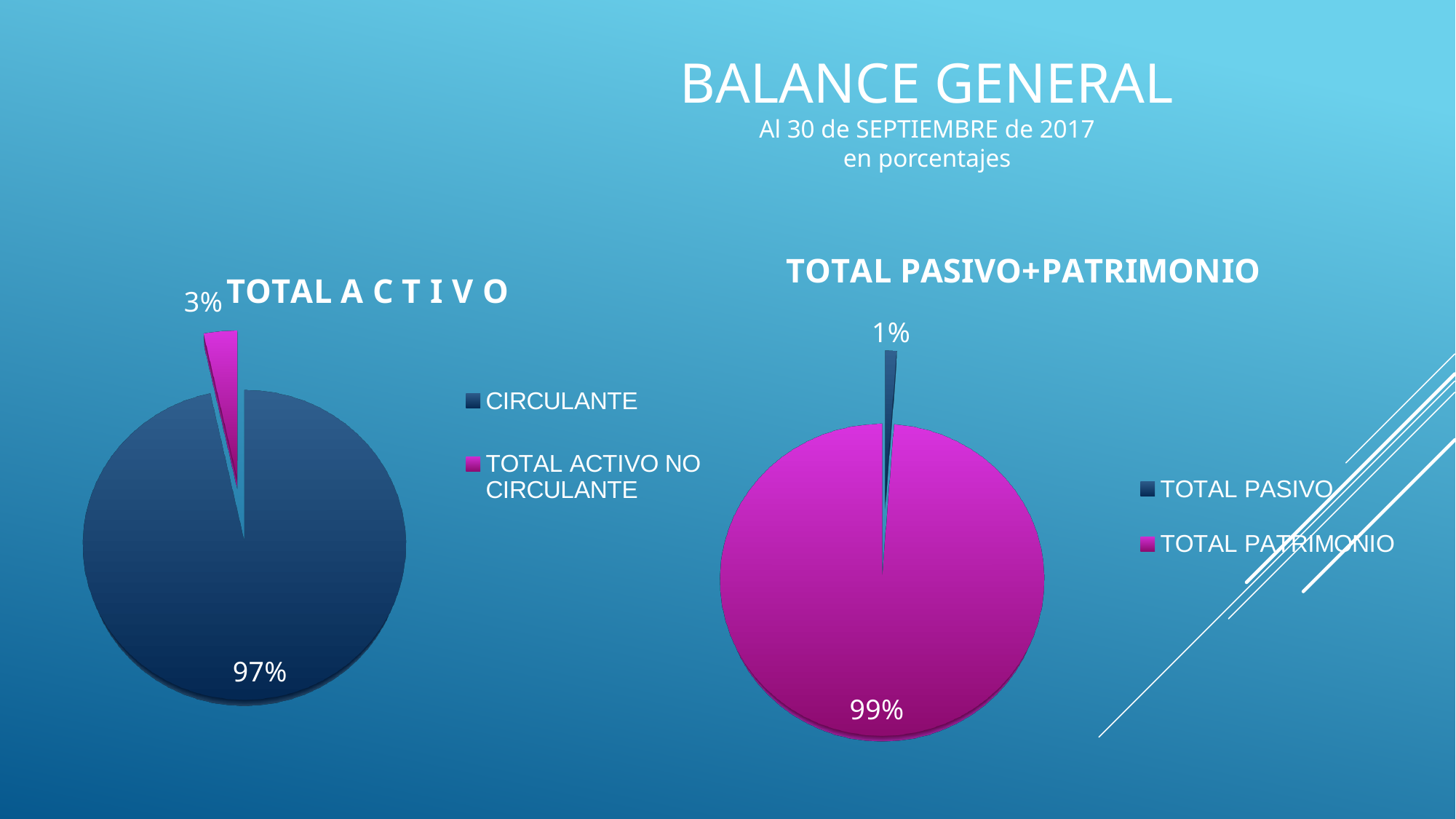
In the TOTAL ACTIVO chart, which category has the largest slice? CIRCULANTE In the TOTAL ACTIVO chart, what share does CIRCULANTE have? 97% In the TOTAL PASIVO+PATRIMONIO chart, which is larger, TOTAL PASIVO or TOTAL PATRIMONIO? TOTAL PATRIMONIO In the TOTAL PASIVO+PATRIMONIO chart, what share does TOTAL PATRIMONIO have? 99% In the TOTAL PASIVO+PATRIMONIO chart, which category has the smallest slice? TOTAL PASIVO In the TOTAL PASIVO+PATRIMONIO chart, what is the difference between the TOTAL PATRIMONIO and TOTAL PASIVO shares? 98% In the TOTAL ACTIVO chart, what share does TOTAL ACTIVO NO CIRCULANTE have? 3% In the TOTAL PASIVO+PATRIMONIO chart, what share does TOTAL PASIVO have? 1% What type of chart is the TOTAL PASIVO+PATRIMONIO chart? Pie chart In the TOTAL ACTIVO chart, what colour is the CIRCULANTE slice? Dark blue How many slices does the TOTAL ACTIVO chart have? 2 In the TOTAL ACTIVO chart, what is the difference between the CIRCULANTE and TOTAL ACTIVO NO CIRCULANTE shares? 94%